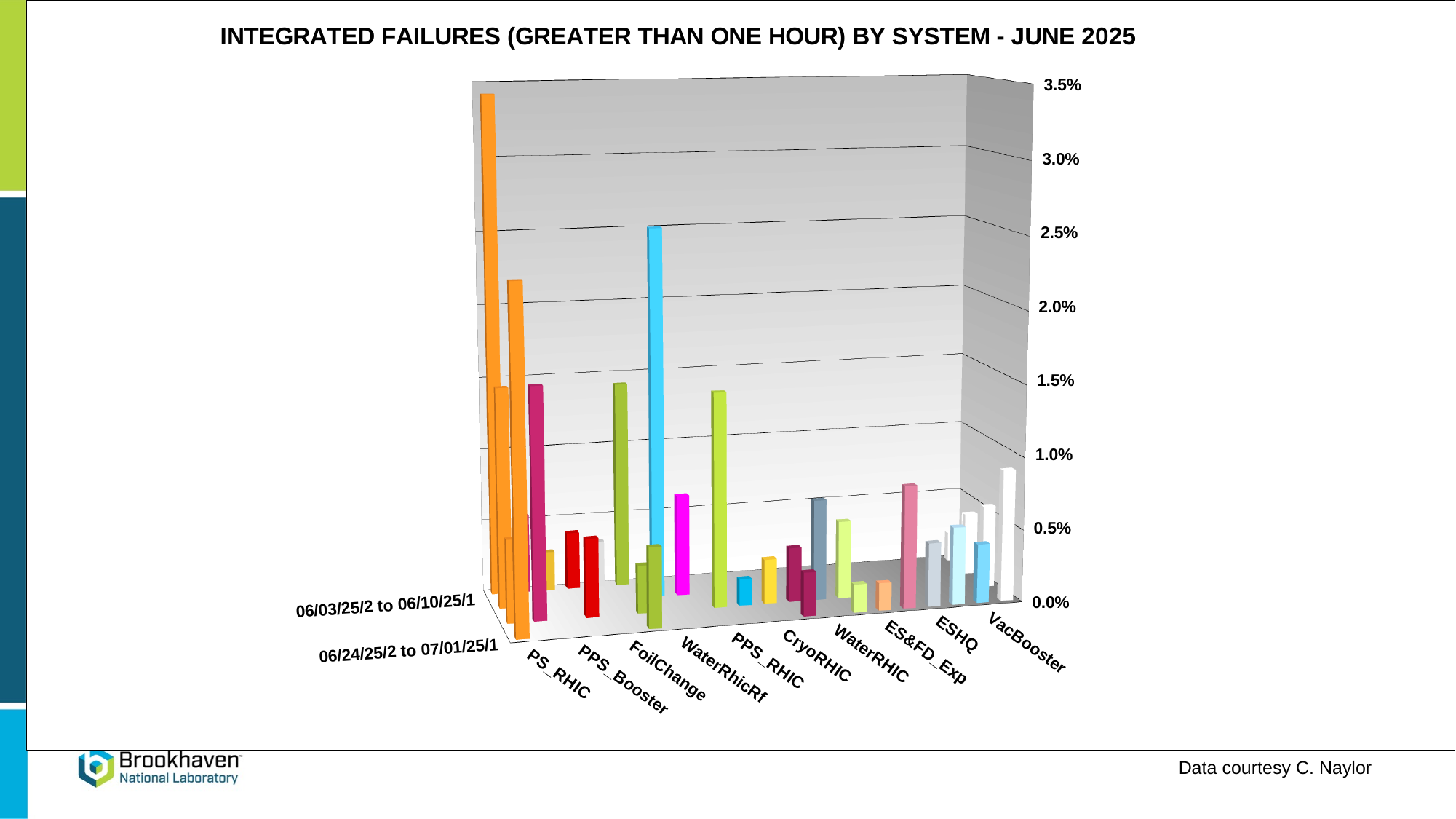
Which has a taller bar, WaterRhicRf or CryoRHIC? WaterRhicRf What is the highest value shown on the vertical axis of the chart? 3.5% Which system has the tallest bar in the chart? PS_RHIC Is the tallest bar for WaterRhicRf greater or less than 2.0%? greater Is the tallest bar for PS_RHIC greater or less than 3.0%? greater Is the tallest bar for CryoRHIC greater or less than 1.0%? less Which has a taller bar, PS_RHIC or VacBooster? PS_RHIC What kind of chart is shown on the slide? bar chart How many system categories are labelled along the x axis of the chart? 10 What is the title of the chart? INTEGRATED FAILURES (GREATER THAN ONE HOUR) BY SYSTEM - JUNE 2025